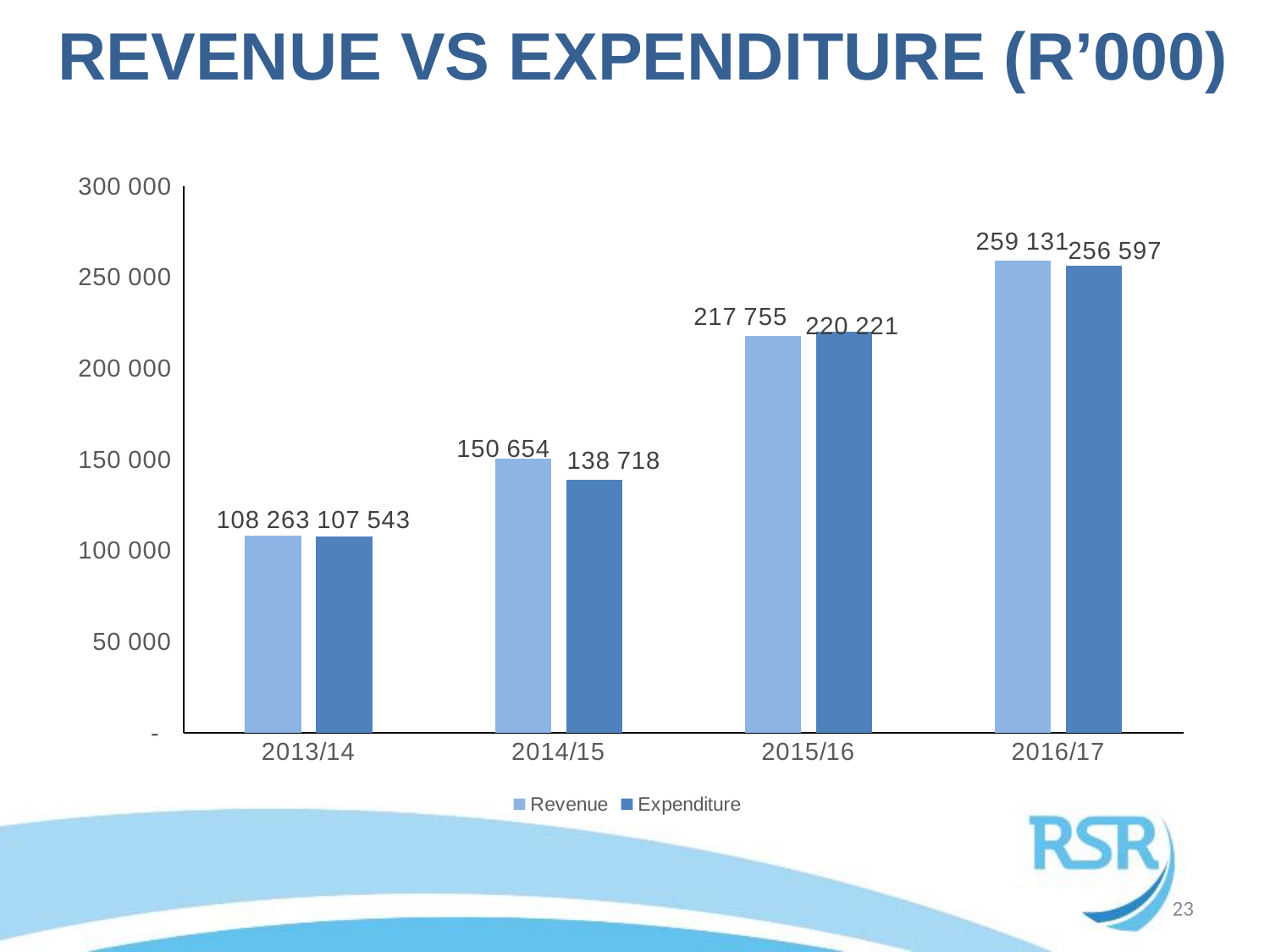
How many years are shown on the x axis? 4 What is the difference between Revenue and Expenditure in 2014/15? 11 936 In 2015/16, which is larger, Revenue or Expenditure? Expenditure What is the Revenue value for 2016/17? 259 131 What is the Expenditure value for 2014/15? 138 718 How many series does the legend list? 2 Which year has the lowest Expenditure? 2013/14 Does Revenue rise or fall from 2013/14 to 2016/17? Rise Which year has the highest Revenue? 2016/17 What is the Expenditure value for 2015/16? 220 221 What is the Revenue value for 2013/14? 108 263 What kind of chart is shown on the slide? Bar chart